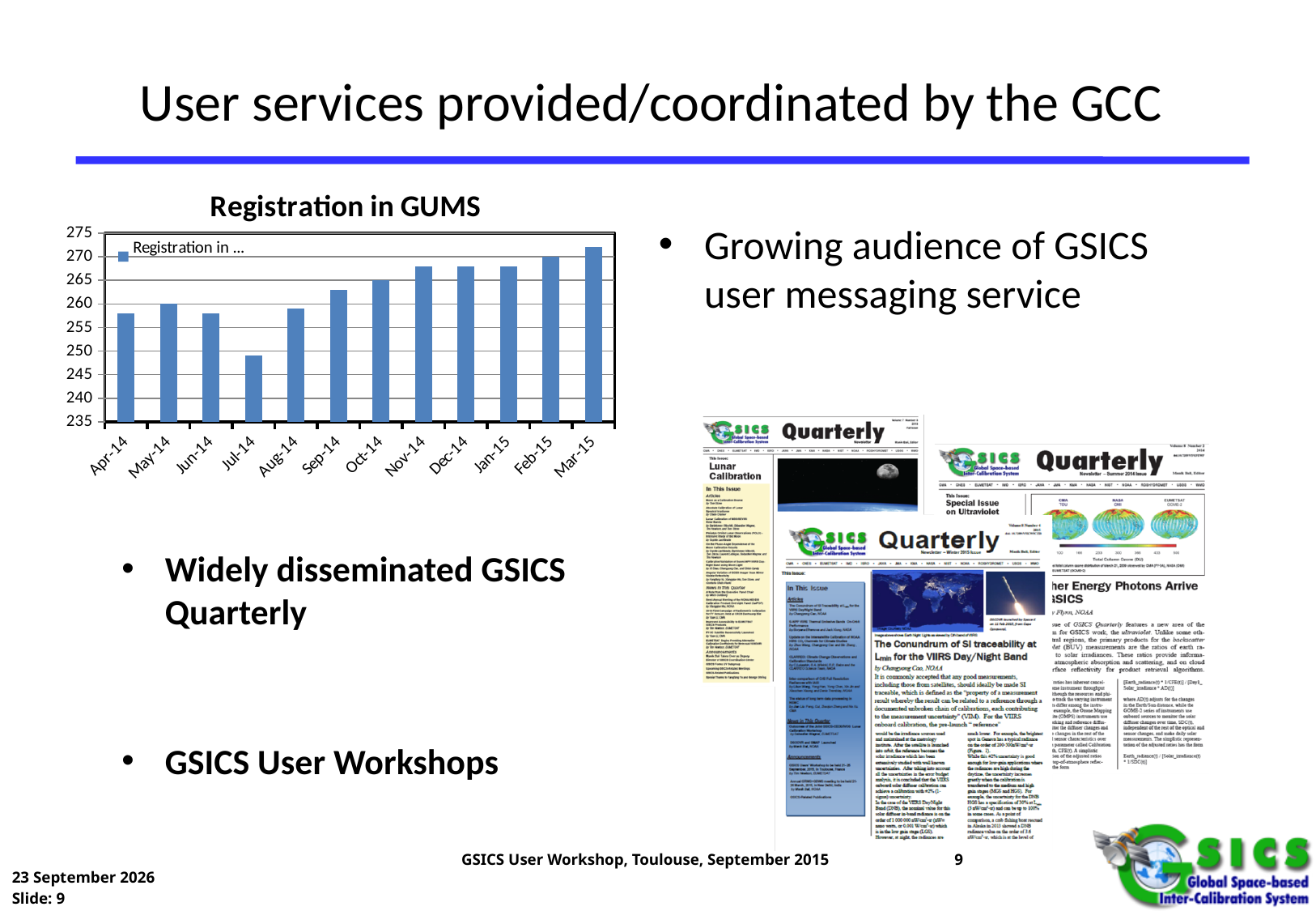
What is the title of the chart? Registration in GUMS Do the registration values generally rise or fall from Aug-14 to Mar-15? rise Is the value for Mar-15 greater or less than 270? greater How many series does the chart's legend list? 1 Which month has the highest registration value? Mar-15 What type of chart is shown on the slide? bar chart Is the value for Sep-14 greater or less than 260? greater Is the value for Jul-14 greater or less than 250? less Which is larger, the value for Jul-14 or the value for Mar-15? Mar-15 How many months are plotted on the x axis of the chart? 12 Which month has the lowest registration value? Jul-14